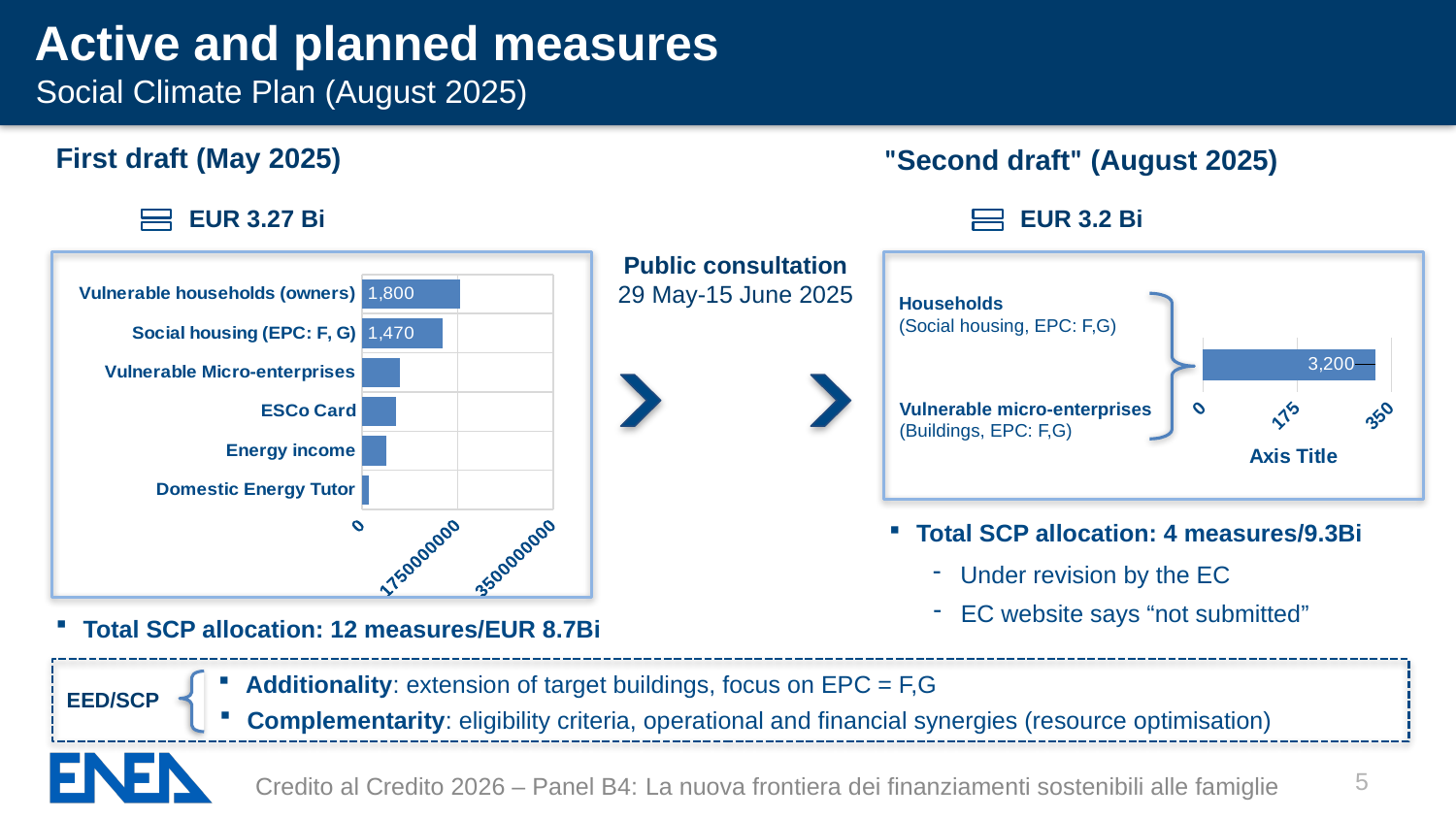
In the left chart (First draft, May 2025), which is larger: the bar for ESCo Card or the bar for Energy income? ESCo Card In the right chart (Second draft, August 2025), what value is printed on the bar? 3,200 What is the axis title shown below the right chart (Second draft, August 2025)? Axis Title In the left chart (First draft, May 2025), what is the value shown for Vulnerable households (owners)? 1,800 In the left chart (First draft, May 2025), which category has the shortest bar? Domestic Energy Tutor What is the highest tick value on the horizontal axis of the left chart (First draft, May 2025)? 3500000000 How many categories are shown in the left chart (First draft, May 2025)? 6 In the left chart (First draft, May 2025), what is the value shown for Social housing (EPC: F,G)? 1,470 In the left chart (First draft, May 2025), is the value for Vulnerable Micro-enterprises greater or less than 1750000000? less In the left chart (First draft, May 2025), which category has the longest bar? Vulnerable households (owners) What kind of chart is the left chart (First draft, May 2025)? Bar chart In the left chart (First draft, May 2025), what is the difference between the values for Vulnerable households (owners) and Social housing (EPC: F,G)? 330